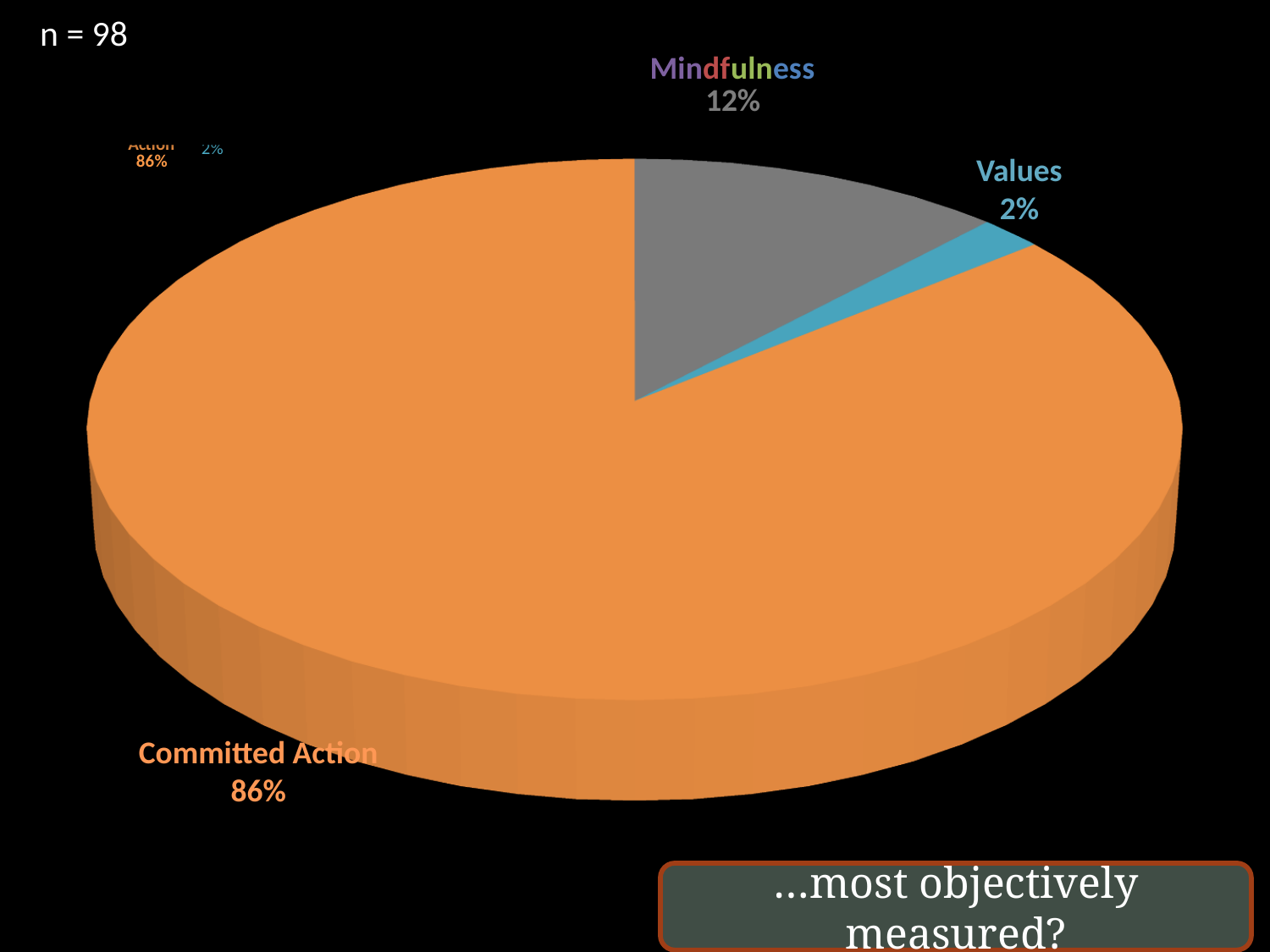
How many slices does the pie chart have? 3 What is the difference in percentage points between Mindfulness and Values? 10 What is the difference in percentage points between Committed Action and Mindfulness? 74 What sample size (n) is stated on the slide? n = 98 Which is larger, the Mindfulness slice or the Values slice? Mindfulness Which category has the smallest slice of the pie? Values What share of the pie does Values have? 2% What share of the pie does Committed Action have? 86% What share of the pie does Mindfulness have? 12% Which category has the largest slice of the pie? Committed Action What kind of chart is shown on the slide? pie chart What colour is the Committed Action slice? orange